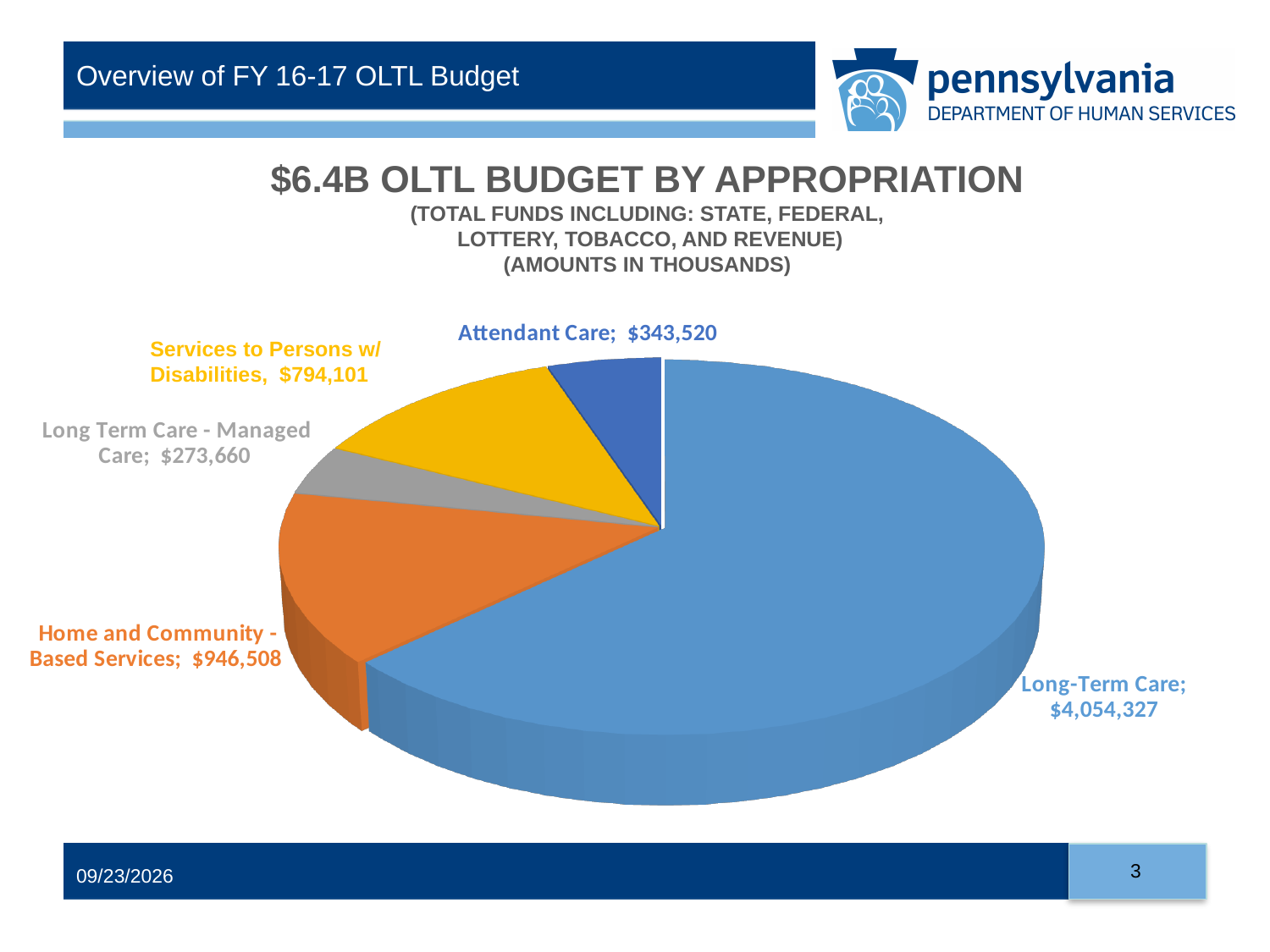
What type of chart is shown on the slide? Pie chart Which appropriation has the largest slice of the pie? Long-Term Care What is the value for Attendant Care? $343,520 What is the value for Long-Term Care? $4,054,327 What is the value for Long Term Care - Managed Care? $273,660 What is the difference between Services to Persons w/ Disabilities and Attendant Care? $450,581 Which appropriation has the smallest slice of the pie? Long Term Care - Managed Care What is the difference between Long-Term Care and Home and Community-Based Services? $3,107,819 Which is larger, Services to Persons w/ Disabilities or Attendant Care? Services to Persons w/ Disabilities How many slices does the pie chart have? 5 What is the title of the chart? $6.4B OLTL BUDGET BY APPROPRIATION What is the value for Home and Community-Based Services? $946,508